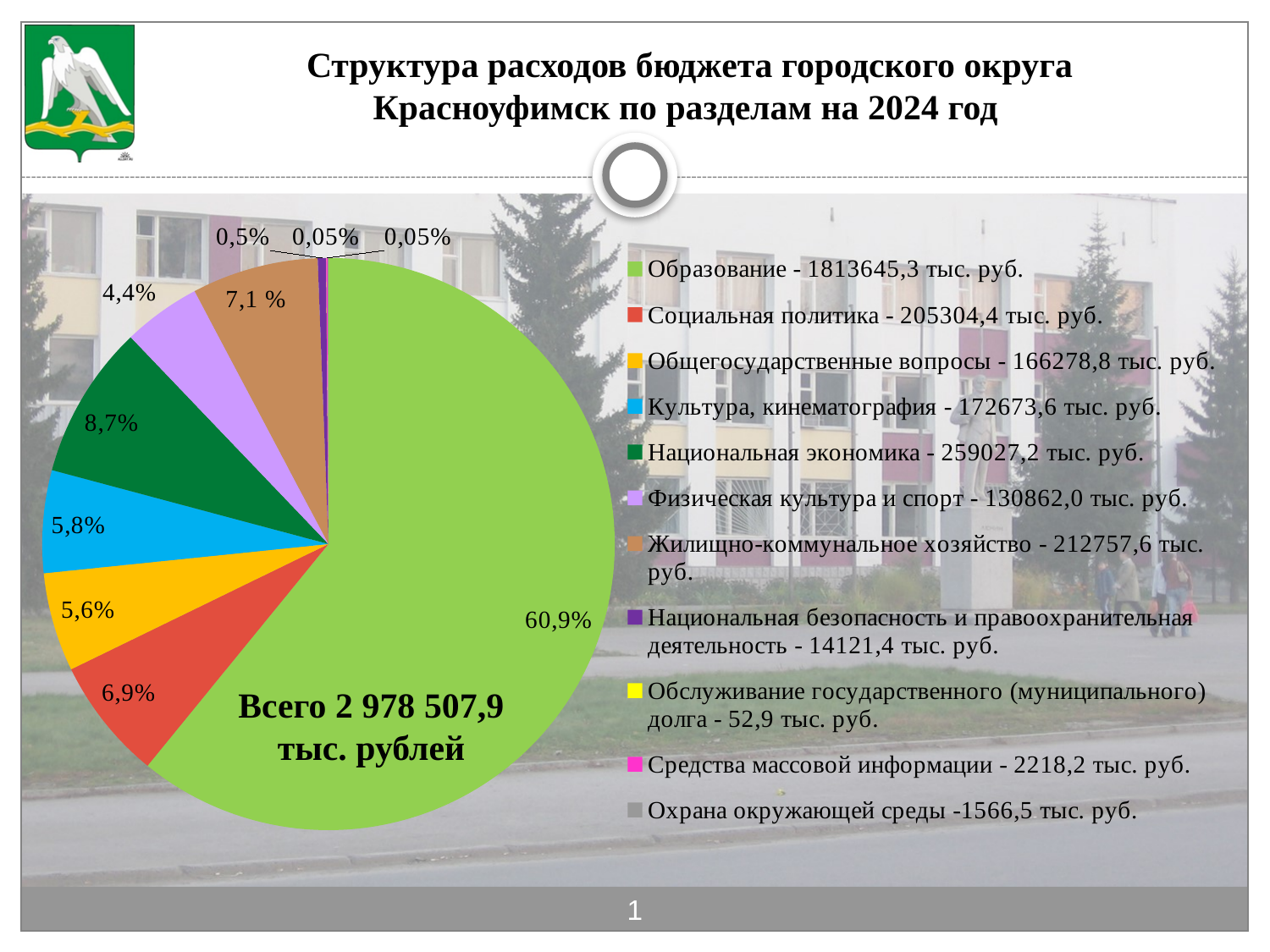
What is the title of the slide? Структура расходов бюджета городского округа Красноуфимск по разделам на 2024 год Which section has the largest share of the budget expenditures? Образование What percentage share does Образование have in the pie chart? 60,9% What percentage share is labelled for Жилищно-коммунальное хозяйство? 7,1 % Which has a larger share: Социальная политика or Общегосударственные вопросы? Социальная политика What kind of chart is shown on the slide? Pie chart What is the amount for Культура, кинематография according to the legend? 172673,6 тыс. руб. What is the total amount of budget expenditures shown on the chart? 2 978 507,9 тыс. рублей By how many percentage points does the share of Национальная экономика exceed the share of Физическая культура и спорт? 4,3 How many expenditure sections are listed in the chart legend? 11 What is the amount for Национальная экономика according to the legend? 259027,2 тыс. руб. Which section has the smallest amount according to the legend? Обслуживание государственного (муниципального) долга